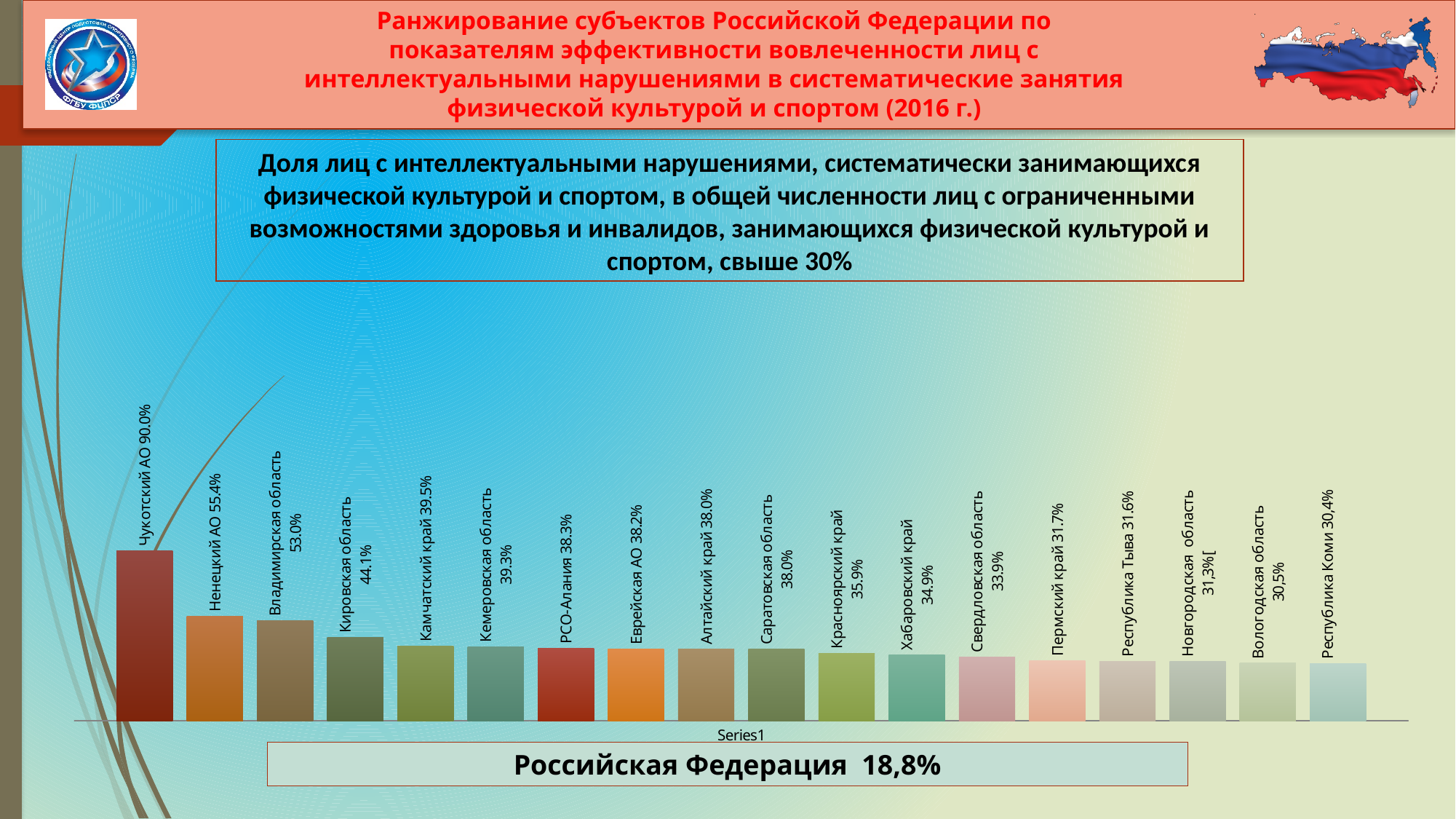
What is the value shown for Республика Коми? 30,4% Which region has the highest value in the chart? Чукотский АО Which region has the lowest value in the chart? Республика Коми What is the difference between the values for Владимирская область and Кировская область? 8.9% What series name is shown below the x axis of the chart? Series1 What is the value shown for Кировская область? 44.1% What is the difference between the values for Чукотский АО and Ненецкий АО? 34.6% Which is larger, the value for Камчатский край or the value for Хабаровский край? Камчатский край Do the values rise or fall moving from left to right along the x axis? fall How many regions (bars) are plotted in the chart? 18 What type of chart is shown on the slide? bar chart What is the value shown for Чукотский АО? 90.0%